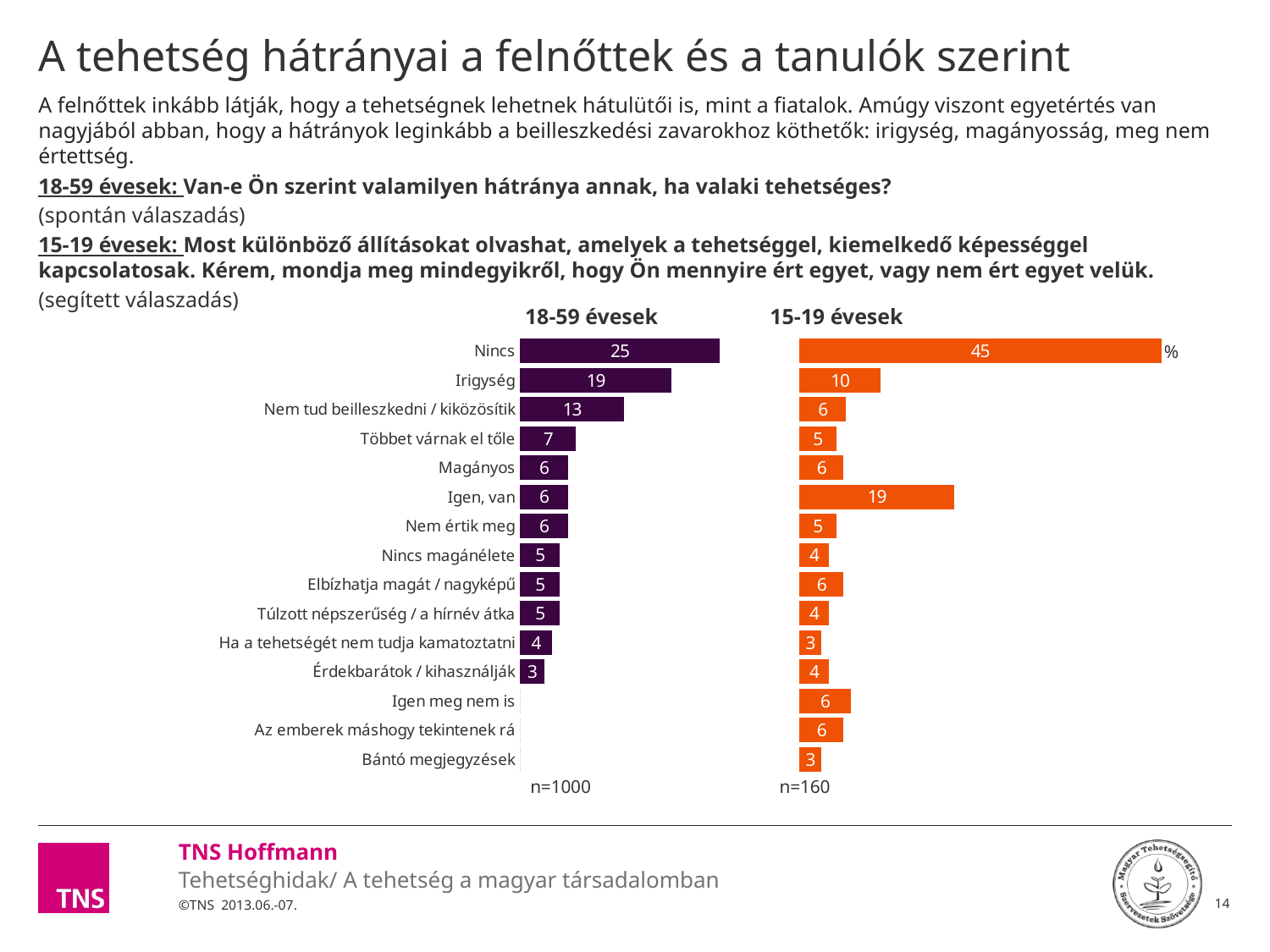
In the 15-19 évesek chart, what is the value for Nincs? 45 What type of chart is used for the 18-59 évesek data? Bar chart In the 18-59 évesek chart, what is the difference between the values for Nincs and Irigység? 6 Which is larger: the value for Igen, van in the 18-59 évesek chart or in the 15-19 évesek chart? 15-19 évesek In the 18-59 évesek chart, what is the value for Nem tud beilleszkedni / kiközösítik? 13 In the 18-59 évesek chart, which category has the highest value? Nincs In the 15-19 évesek chart, which category has the highest value? Nincs What sample size (n) is shown under the 15-19 évesek chart? n=160 In the 15-19 évesek chart, what is the value for Igen, van? 19 In the 15-19 évesek chart, what is the difference between the values for Nincs and Igen, van? 26 In the 18-59 évesek chart, what is the value for Irigység? 19 Which is larger: the value for Irigység in the 18-59 évesek chart or in the 15-19 évesek chart? 18-59 évesek